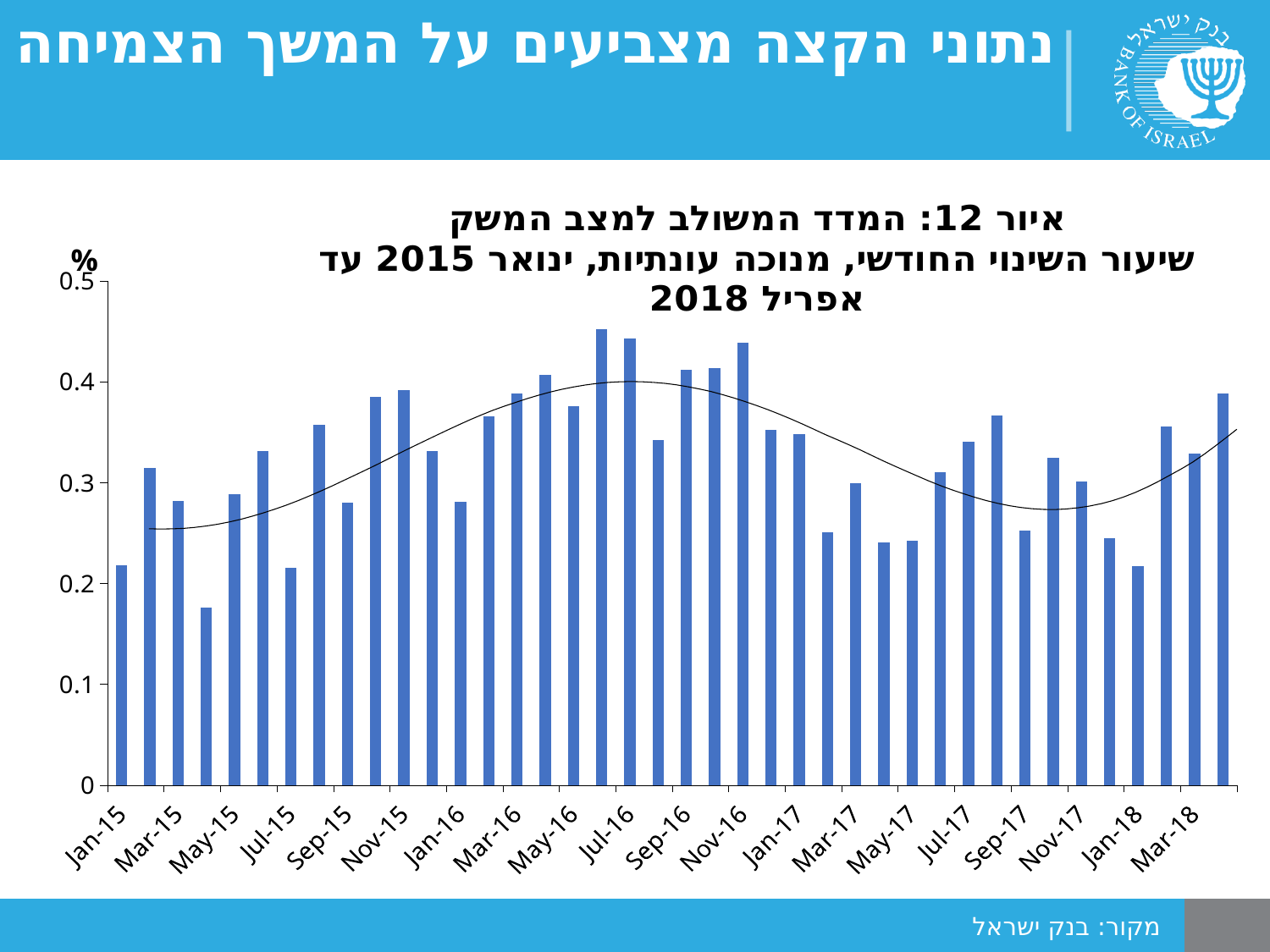
Is the value for Jan-15 greater or less than 0.3? less Does the smooth trend line rise or fall between Jul-16 and Sep-17? fall How many bars are plotted in the chart? 40 Is the value for Nov-16 greater or less than 0.4? greater Is the value for Sep-17 greater or less than 0.3? less Which is larger, the value for Jan-15 or the value for Nov-15? Nov-15 Which is larger, the value for Jul-16 or the value for Jan-17? Jul-16 What unit is shown at the top of the vertical axis? % What kind of chart is shown on the slide? bar chart